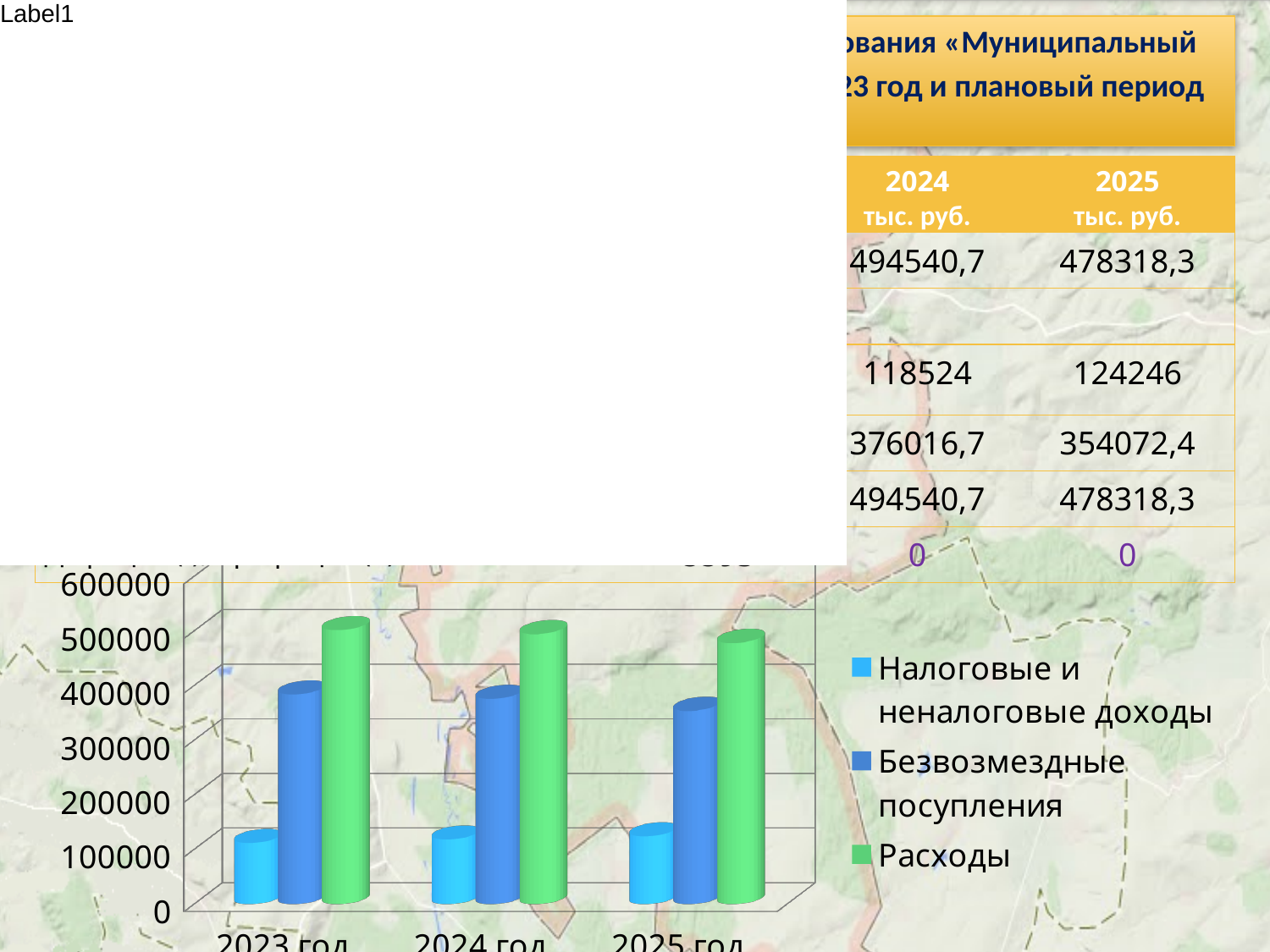
Which series has the shortest bar for 2023 год? Налоговые и неналоговые доходы Is the value for Безвозмездные посупления in 2025 год greater or less than 300000? greater How many year categories are shown on the x axis of the chart? 3 Which series has the tallest bar for 2024 год? Расходы Do the Расходы bars rise or fall from 2023 год to 2025 год? fall What colour represents the Расходы series in the chart legend? green What kind of chart is shown on the slide? bar chart Which is larger in 2025 год: Расходы or Безвозмездные посупления? Расходы Is the value for Расходы in 2023 год greater or less than 400000? greater Is the value for Налоговые и неналоговые доходы in 2023 год greater or less than 200000? less How many series does the chart legend list? 3